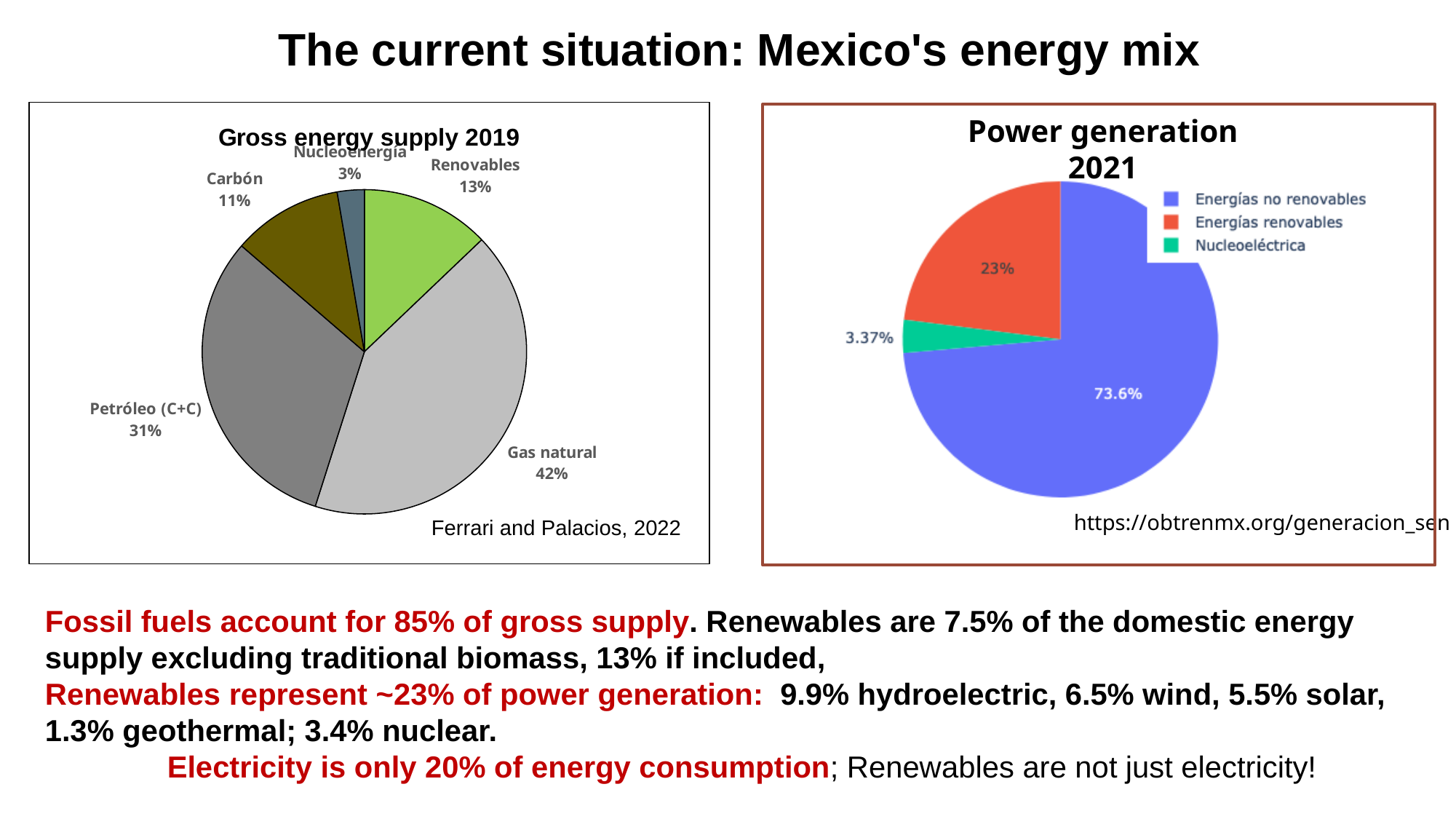
In the 'Gross energy supply 2019' chart, which category has the smallest share? Nucleoenergía In the 'Gross energy supply 2019' chart, what share does Gas natural have? 42% In the 'Gross energy supply 2019' chart, how many categories are shown? 5 In the 'Gross energy supply 2019' chart, which is larger, Carbón or Renovables? Renovables In the 'Gross energy supply 2019' chart, which category has the largest share? Gas natural What kind of chart is the 'Power generation 2021' chart? Pie chart In the 'Gross energy supply 2019' chart, what share does Petróleo (C+C) have? 31% In the 'Gross energy supply 2019' chart, what is the difference between the shares of Gas natural and Petróleo (C+C)? 11% In the 'Power generation 2021' chart, what share does Energías no renovables have? 73.6% In the 'Power generation 2021' chart, how many entries does the legend list? 3 In the 'Power generation 2021' chart, what share does Nucleoeléctrica have? 3.37% In the 'Power generation 2021' chart, what colour is the Energías renovables slice? Red